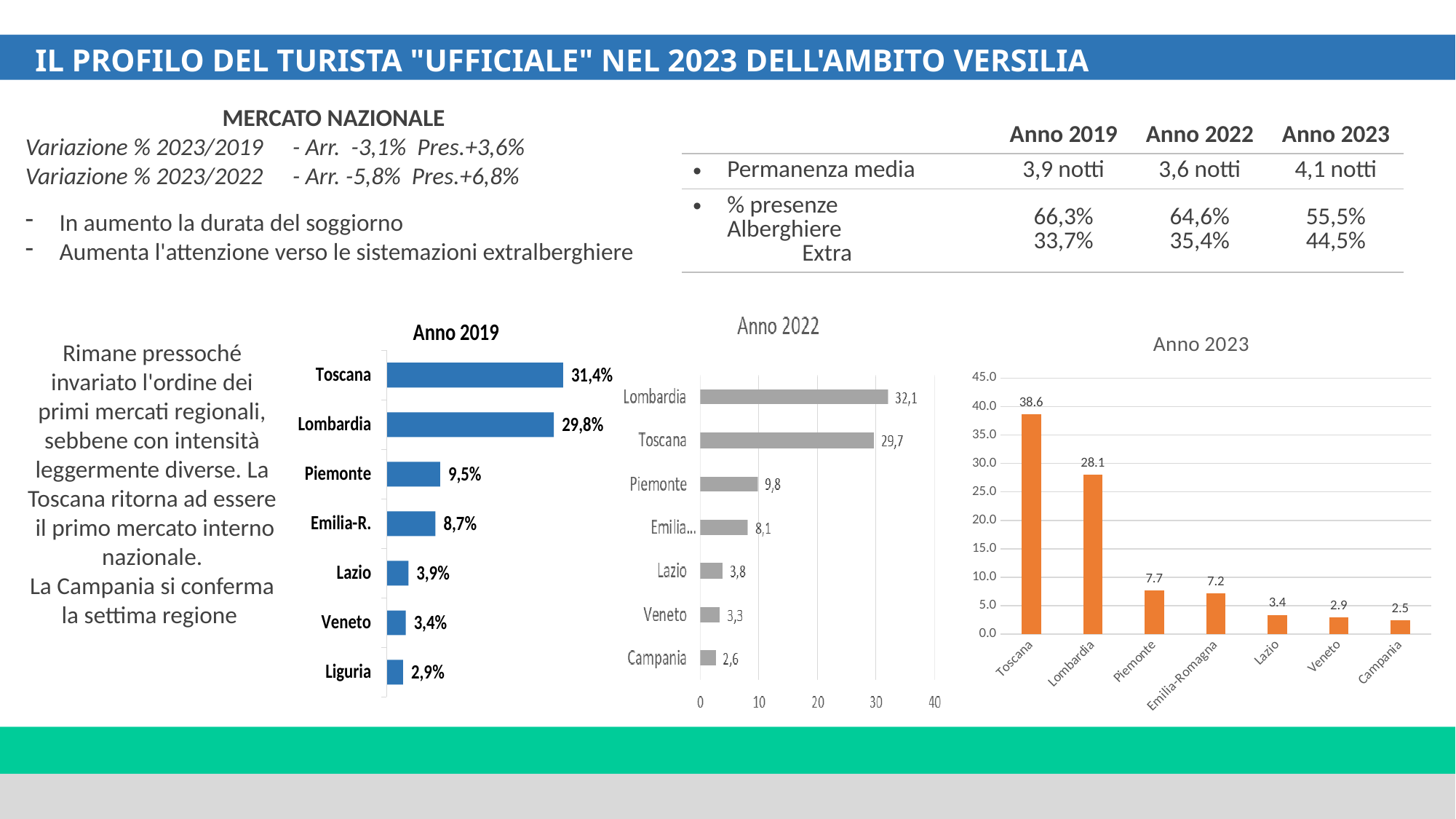
In the "Anno 2023" chart, what is the value for Toscana? 38.6 In the "Anno 2022" chart, how many regions are plotted? 7 In the "Anno 2022" chart, what is the value for Piemonte? 9,8 In the "Anno 2019" chart, which region has the lowest value? Liguria In the "Anno 2023" chart, which is larger, the value for Piemonte or the value for Emilia-Romagna? Piemonte In the "Anno 2023" chart, what is the value for Campania? 2.5 What colour are the bars in the "Anno 2022" chart? Gray In the "Anno 2019" chart, what is the difference between the values for Toscana and Lombardia? 1,6% In the "Anno 2019" chart, what is the value for Toscana? 31,4% In the "Anno 2023" chart, what is the difference between the values for Toscana and Lombardia? 10.5 What kind of chart is the "Anno 2023" chart? Bar chart In the "Anno 2022" chart, which region has the highest value? Lombardia